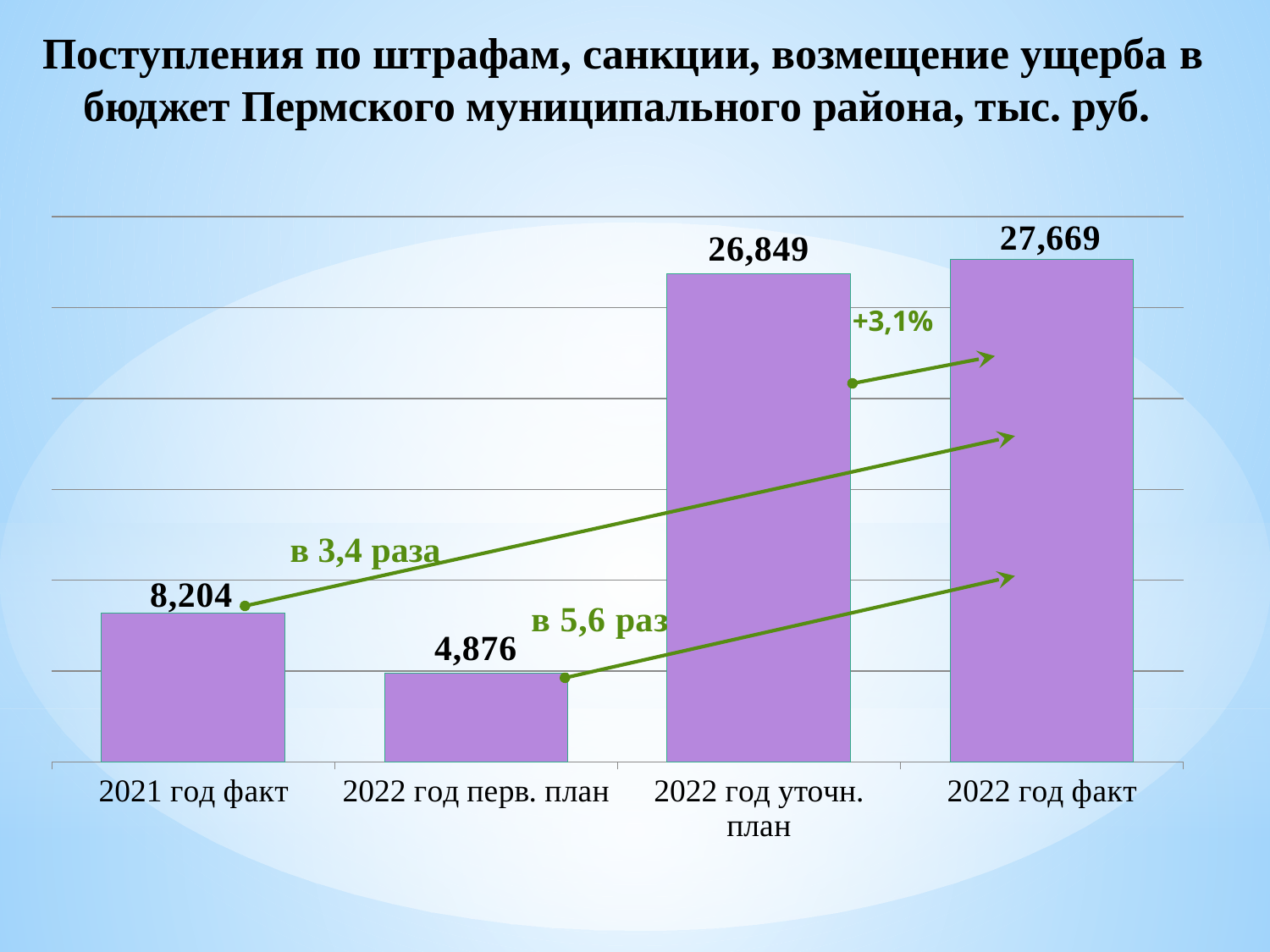
What is the difference between the values for 2022 год факт and 2022 год уточн. план? 820 What kind of chart is shown on the slide? Bar chart Which category has the lowest value? 2022 год перв. план Which is larger, the value for 2021 год факт or the value for 2022 год перв. план? 2021 год факт What percentage change is annotated between 2022 год уточн. план and 2022 год факт? +3,1% What is the difference between the values for 2021 год факт and 2022 год перв. план? 3,328 How many categories are shown on the x axis? 4 What is the value for 2022 год перв. план? 4,876 What is the value for 2021 год факт? 8,204 What is the value for 2022 год уточн. план? 26,849 Which category has the highest value? 2022 год факт What is the value for 2022 год факт? 27,669